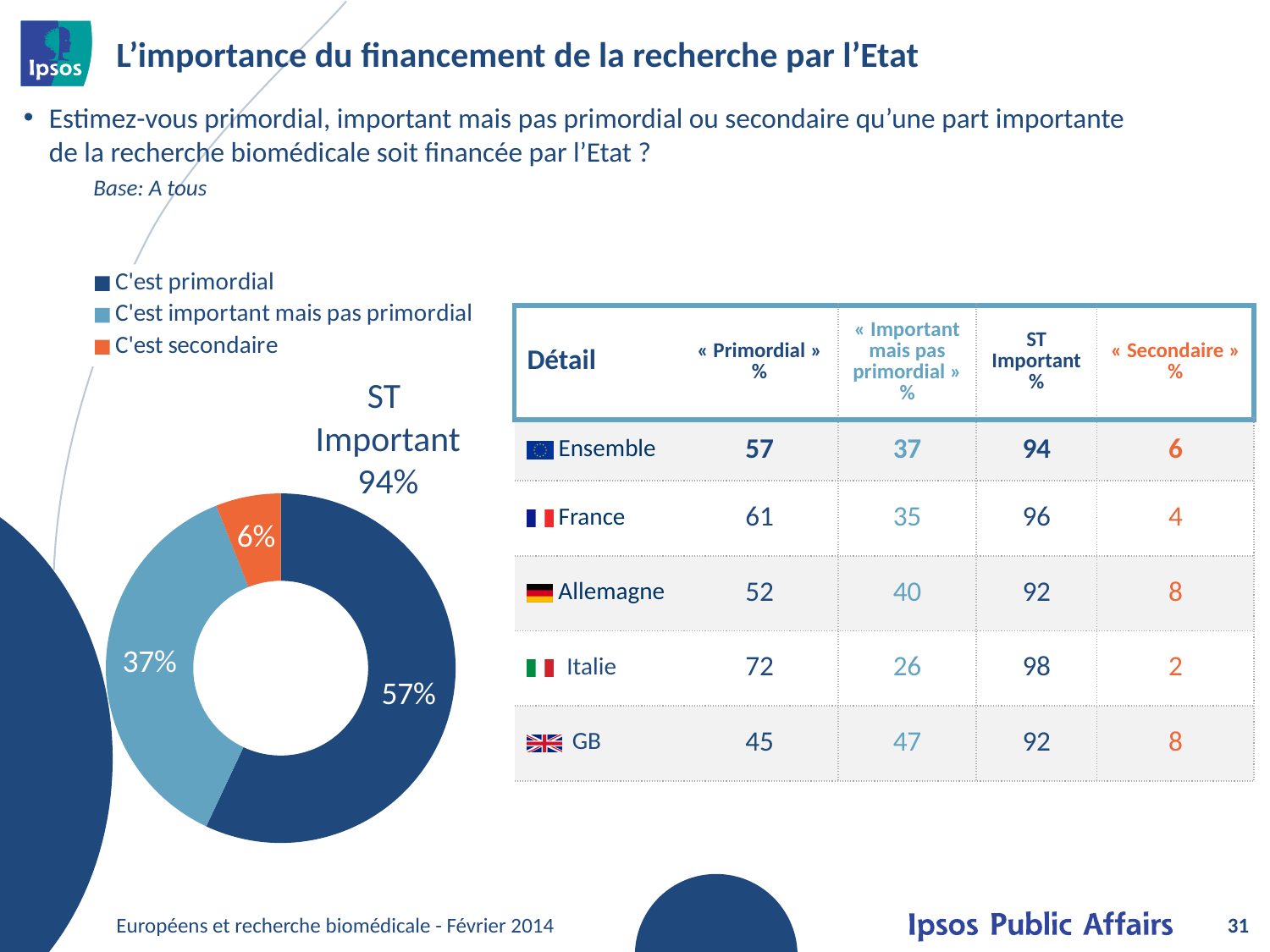
How many slices does the pie chart have? 3 What is the combined share of "C'est primordial" and "C'est important mais pas primordial" shown as "ST Important" on the chart? 94% What percentage of the pie chart corresponds to "C'est primordial"? 57% What is the difference between the "C'est primordial" slice and the "C'est important mais pas primordial" slice? 20% How many entries does the legend of the pie chart list? 3 What percentage of the pie chart corresponds to "C'est secondaire"? 6% What type of chart is shown on the slide? Pie chart (donut) Which category has the largest slice in the pie chart? C'est primordial What percentage of the pie chart corresponds to "C'est important mais pas primordial"? 37% Which category has the smallest slice in the pie chart? C'est secondaire What colour is the "C'est secondaire" slice in the pie chart? Orange Which is larger in the pie chart: "C'est important mais pas primordial" or "C'est secondaire"? C'est important mais pas primordial